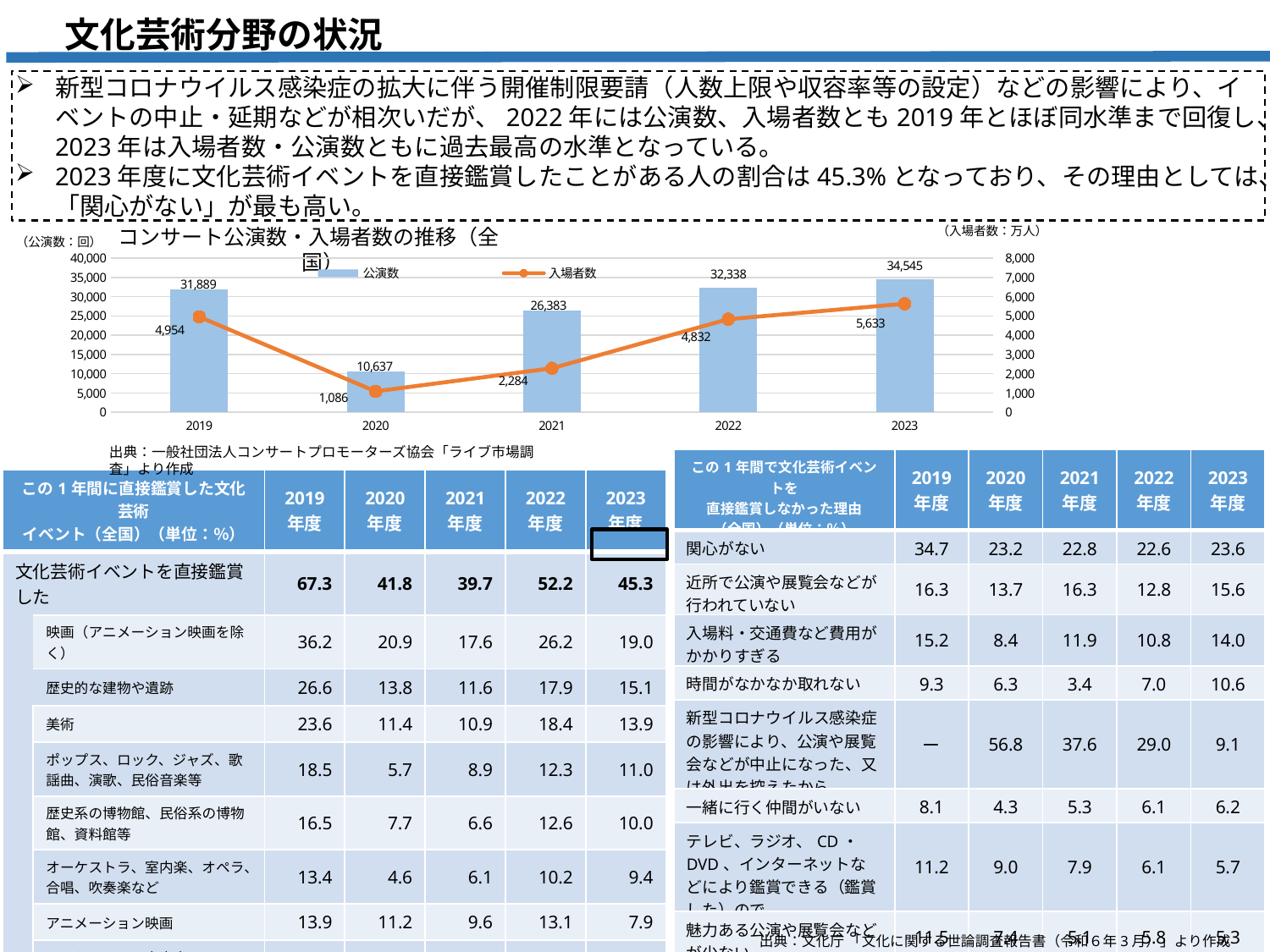
What type of chart is used to show コンサート公演数・入場者数の推移（全国）? Combined bar and line chart In the コンサート公演数・入場者数の推移 chart, does 入場者数 rise or fall from 2020 to 2023? Rise In the コンサート公演数・入場者数の推移 chart, is 公演数 higher in 2019 or in 2021? 2019 In the コンサート公演数・入場者数の推移 chart, what is the value of 公演数 for 2020? 10,637 In the コンサート公演数・入場者数の推移 chart, what is the difference in 入場者数 between 2021 and 2020? 1,198 In the コンサート公演数・入場者数の推移 chart, what is the difference in 公演数 between 2023 and 2022? 2,207 How many series does the legend of the コンサート公演数・入場者数の推移 chart list? 2 How many years are shown on the x axis of the コンサート公演数・入場者数の推移 chart? 5 In the コンサート公演数・入場者数の推移 chart, what is the value of 入場者数 for 2023? 5,633 In the コンサート公演数・入場者数の推移 chart, which year has the highest 公演数? 2023 In the コンサート公演数・入場者数の推移 chart, which year has the lowest 入場者数? 2020 In the コンサート公演数・入場者数の推移 chart, what is the value of 入場者数 for 2019? 4,954